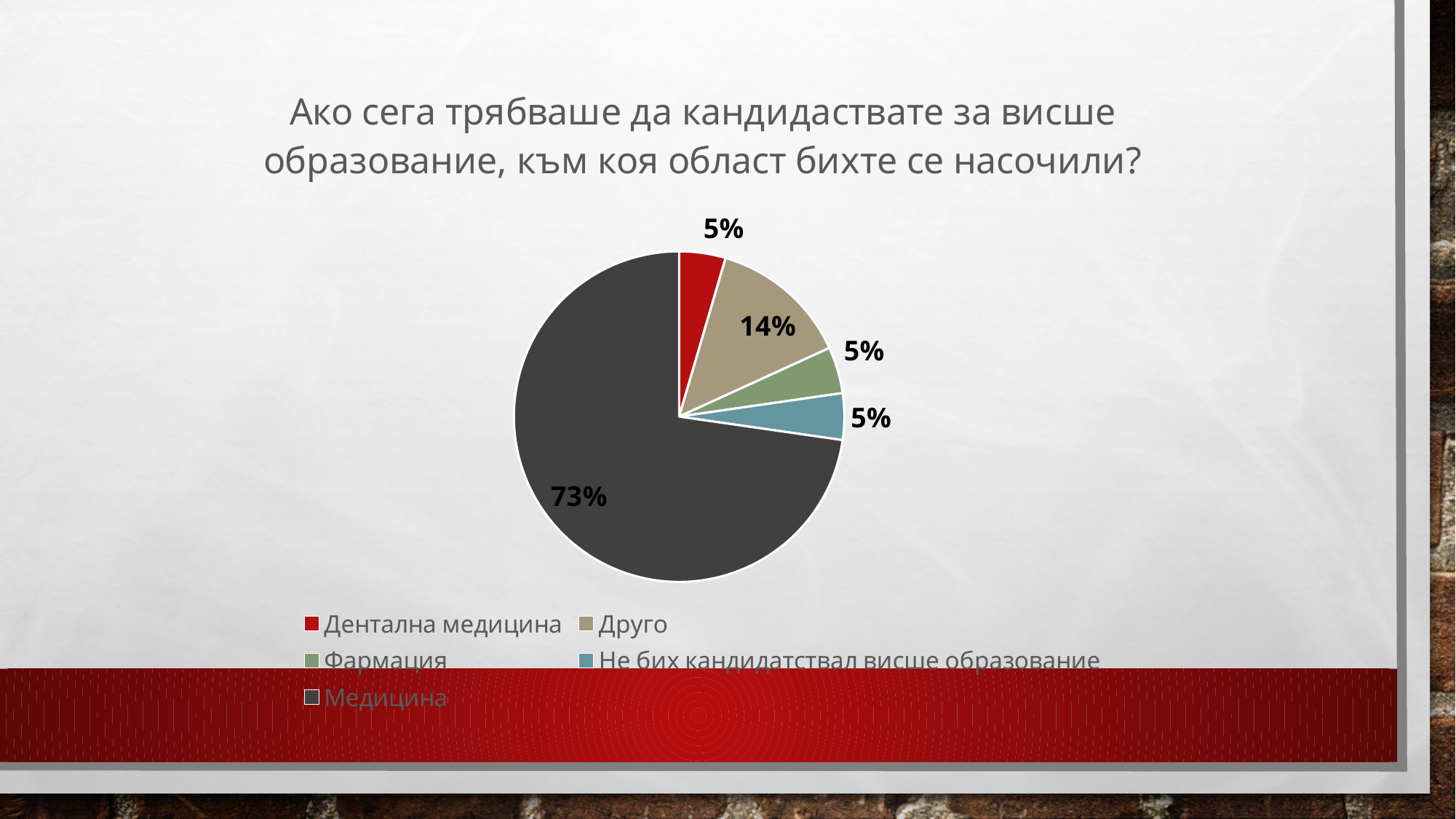
Which category has the largest slice of the pie? Медицина What share of the pie does Не бих кандидатствал висше образование have? 5% What kind of chart is shown on the slide? pie chart What share of the pie does Фармация have? 5% Which is larger, the share for Друго or the share for Дентална медицина? Друго What share of the pie does Друго have? 14% How many categories does the pie chart have? 5 What is the difference between the shares for Медицина and Друго? 59% What share of the pie does Медицина have? 73% What share of the pie does Дентална медицина have? 5% What colour is the slice for Дентална медицина? red What is the difference between the shares for Друго and Фармация? 9%